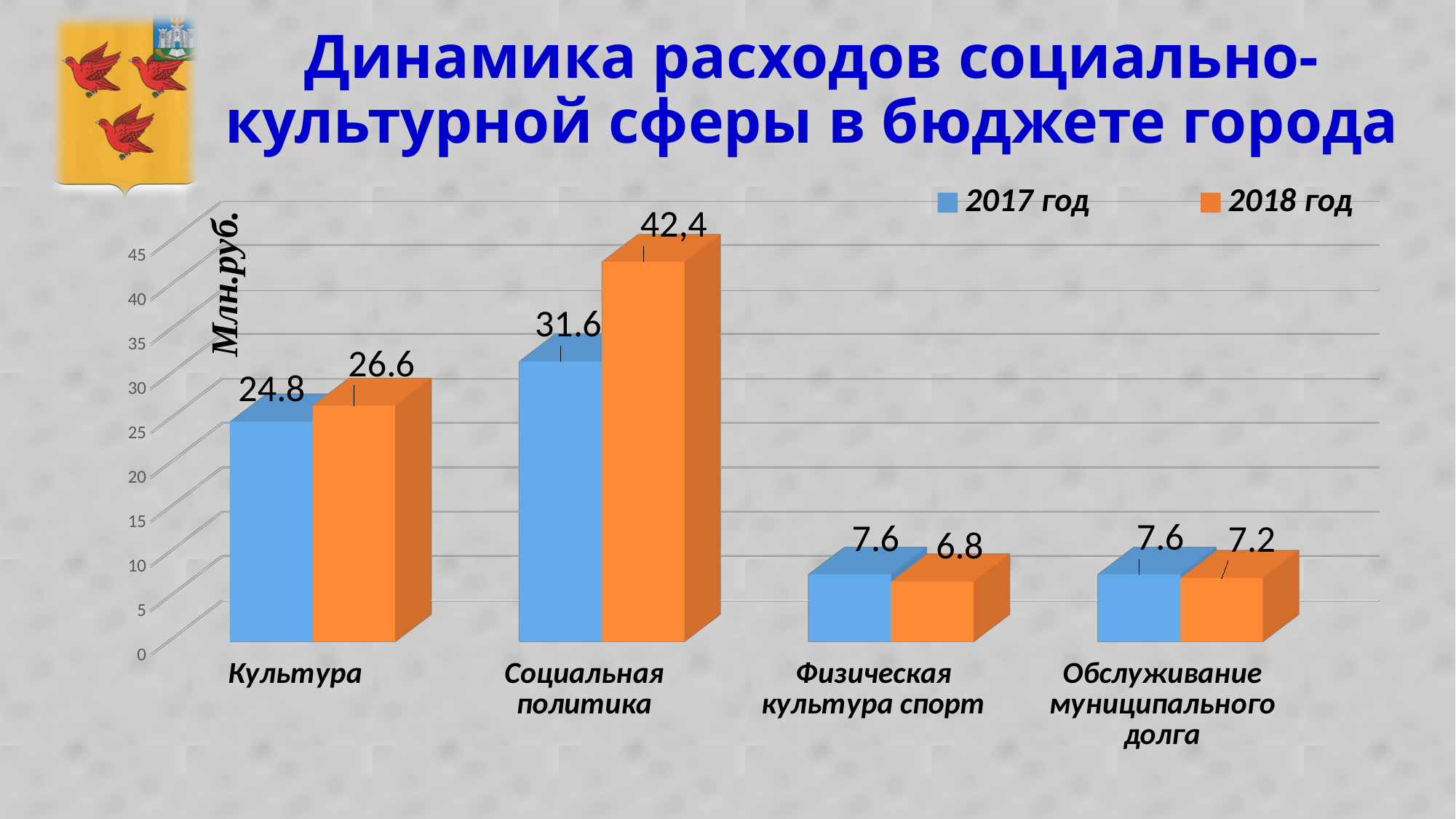
How many series does the legend list? 2 Which is larger for Обслуживание муниципального долга: the 2017 год value or the 2018 год value? 2017 год What is the value for Социальная политика in 2018 год? 42,4 What unit is given on the vertical axis label? Млн.руб. What is the value for Культура in 2017 год? 24.8 Which category has the highest value in 2018 год? Социальная политика What is the value for Обслуживание муниципального долга in 2017 год? 7.6 How many categories are shown on the x axis? 4 What is the value for Физическая культура спорт in 2018 год? 6.8 What is the difference between the 2018 год and 2017 год values for Культура? 1.8 Which category has the lowest value in 2018 год? Физическая культура спорт What kind of chart is shown on the slide? Bar chart